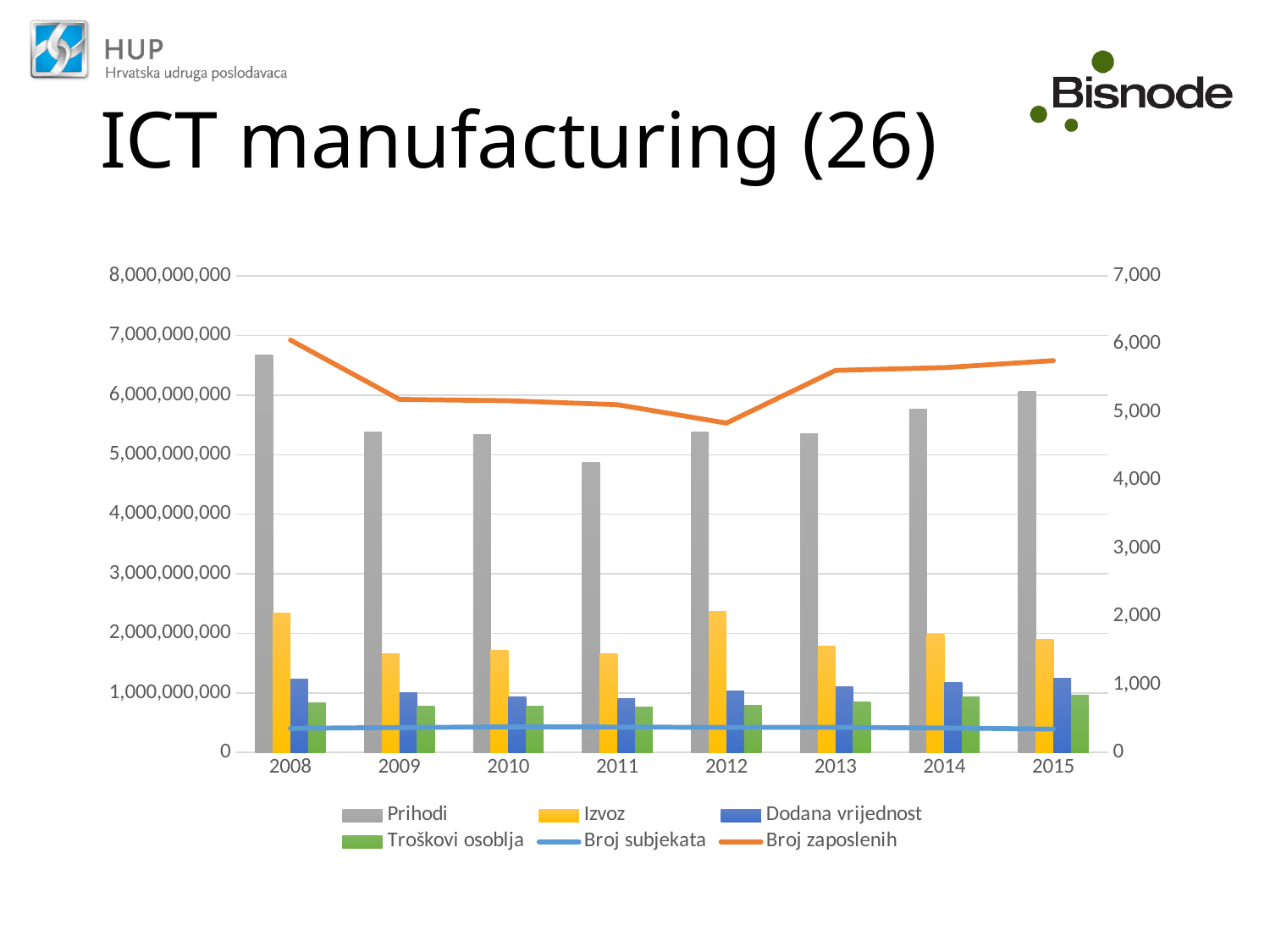
How many years are shown on the x axis? 8 Is the value of Prihodi for 2008 greater or less than 6,000,000,000? greater Does Broj zaposlenih rise or fall from 2008 to 2012? fall How many series does the legend list? 6 Is the value of Prihodi for 2011 greater or less than 5,000,000,000? less What kind of chart is shown on the slide? A combination bar and line chart Which year has the larger Izvoz value, 2008 or 2009? 2008 In which year is Prihodi highest? 2008 In which year is Prihodi lowest? 2011 Is the value of Izvoz for 2012 greater or less than 2,000,000,000? greater In which year is Broj zaposlenih lowest? 2012